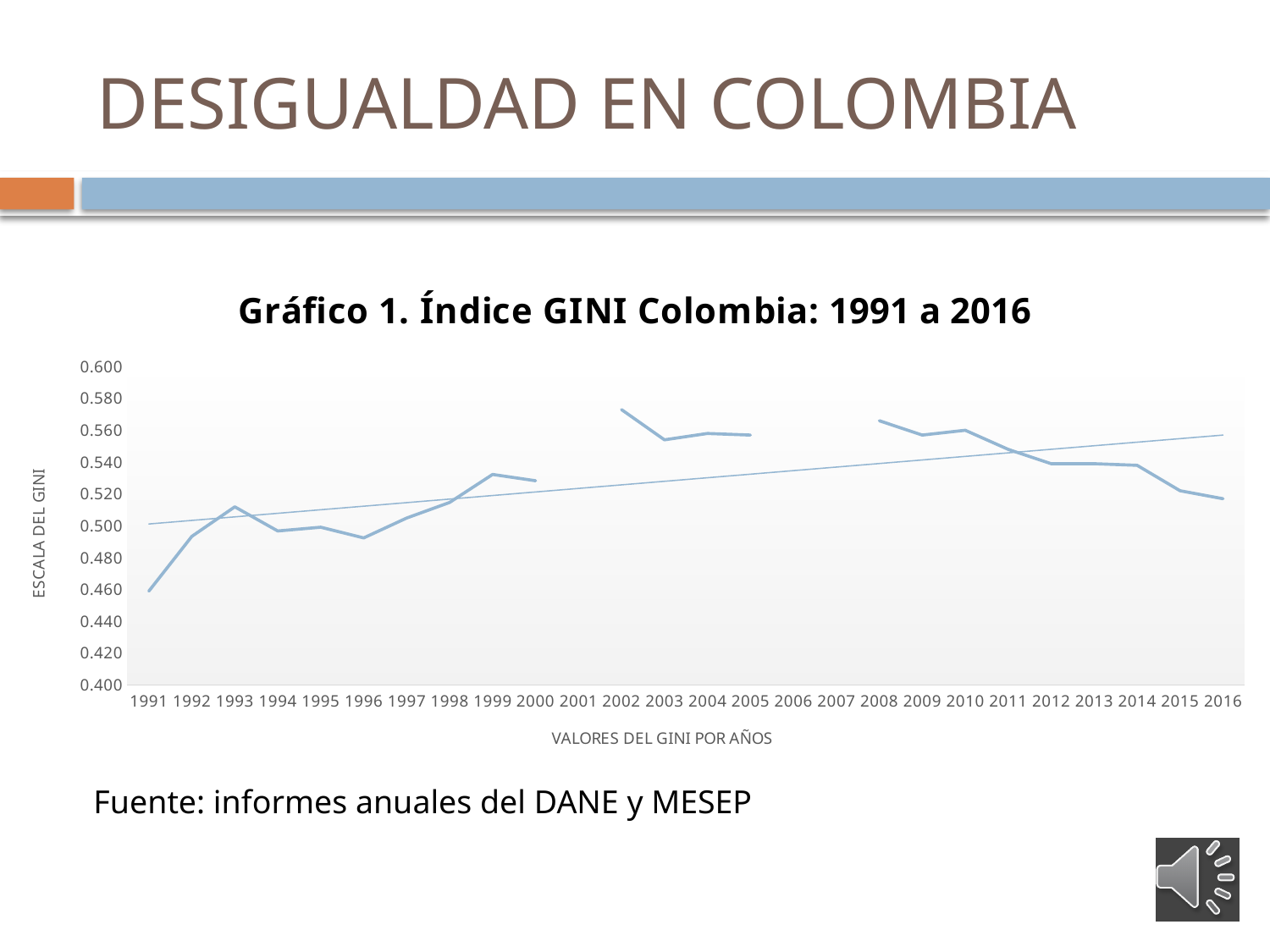
Is the value for 2002 greater or less than 0.560? greater Is the value for 2016 greater or less than 0.500? greater What is the title of the chart? Gráfico 1. Índice GINI Colombia: 1991 a 2016 Which year has the highest GINI value? 2002 What is the label of the vertical axis? ESCALA DEL GINI How many years are labelled on the x axis? 26 According to the straight trend line, do GINI values generally rise or fall from 1991 to 2016? Rise Which year has the lowest GINI value? 1991 Which year has the larger GINI value, 1991 or 2016? 2016 What kind of chart is shown on the slide? Line chart Is the value for 1999 greater or less than 0.520? greater